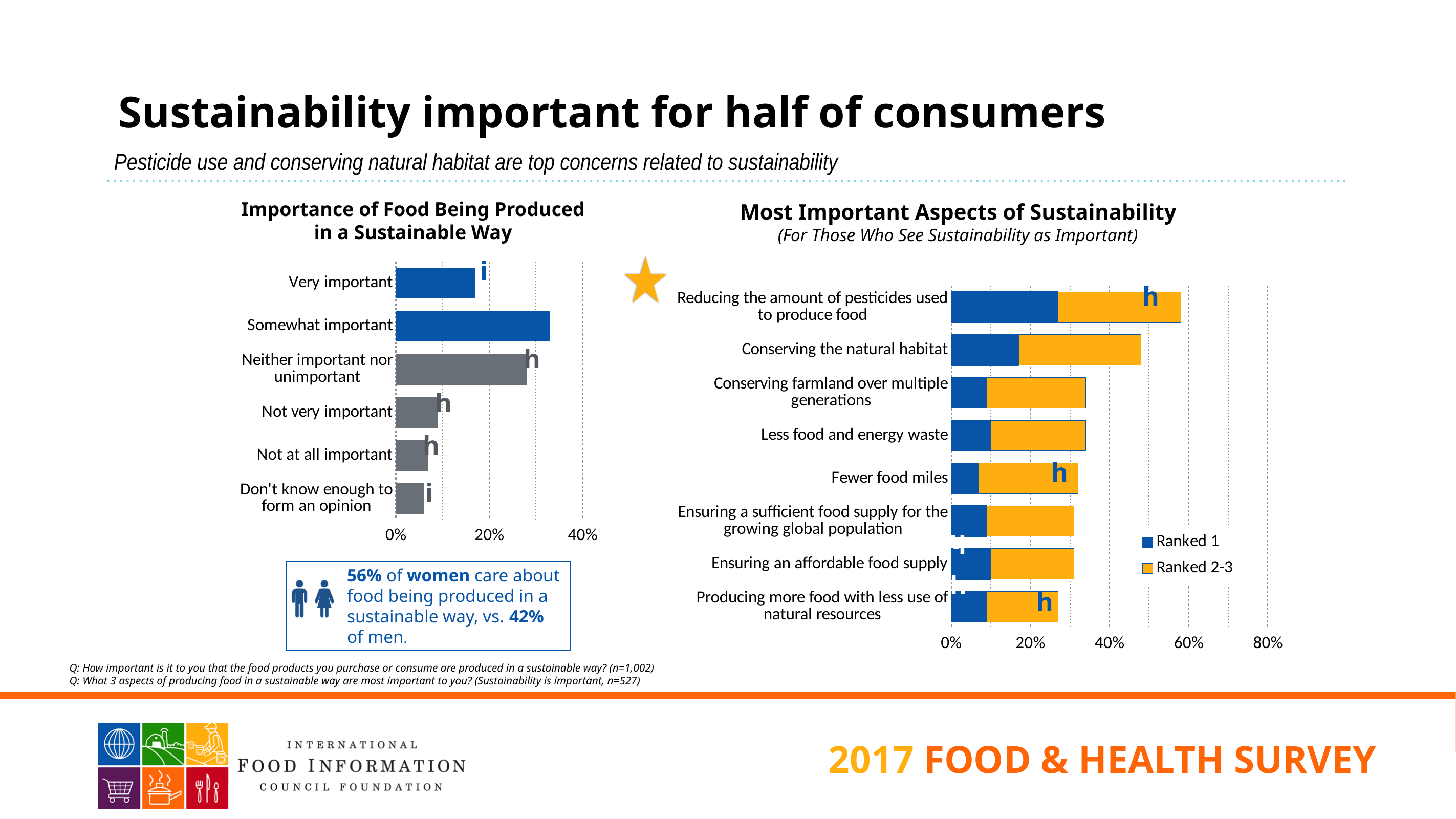
In the 'Importance of Food Being Produced in a Sustainable Way' chart, is the value for 'Very important' greater or less than 20%? less How many categories are shown in the 'Most Important Aspects of Sustainability' chart? 8 In the 'Importance of Food Being Produced in a Sustainable Way' chart, is the value for 'Neither important nor unimportant' greater or less than 20%? greater In the 'Most Important Aspects of Sustainability' chart, is the total bar for 'Conserving the natural habitat' greater or less than 40%? greater In the 'Importance of Food Being Produced in a Sustainable Way' chart, which category has the highest value? Somewhat important How many categories are shown in the 'Importance of Food Being Produced in a Sustainable Way' chart? 6 In the 'Importance of Food Being Produced in a Sustainable Way' chart, which is larger: 'Very important' or 'Somewhat important'? Somewhat important What are the two legend entries in the 'Most Important Aspects of Sustainability' chart? Ranked 1 and Ranked 2-3 In the 'Most Important Aspects of Sustainability' chart, which category has the shortest total bar? Producing more food with less use of natural resources How many series does the legend of the 'Most Important Aspects of Sustainability' chart list? 2 What kind of chart is the 'Importance of Food Being Produced in a Sustainable Way' chart? Bar chart In the 'Most Important Aspects of Sustainability' chart, which category has the longest total bar? Reducing the amount of pesticides used to produce food